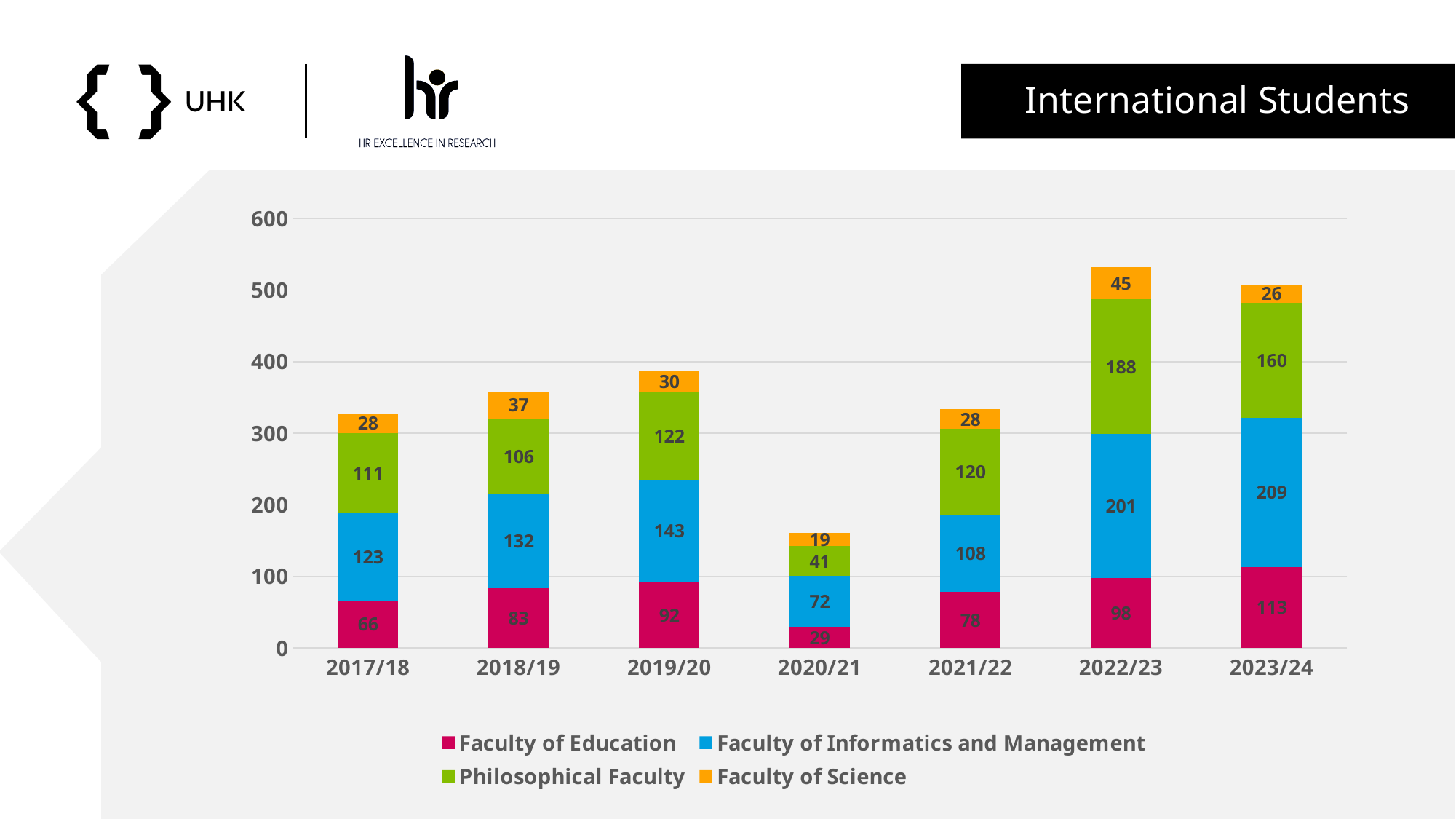
What is the total of the stacked bar for 2022/23? 532 In which academic year is the Faculty of Informatics and Management value the lowest? 2020/21 What kind of chart is shown on the slide? Stacked bar chart What is the total of the stacked bar for 2020/21? 161 What is the value for the Faculty of Informatics and Management in 2022/23? 201 What is the value for the Faculty of Science in 2020/21? 19 What is the value for the Philosophical Faculty in 2019/20? 122 In which academic year is the Faculty of Education value the highest? 2023/24 What is the difference between the Philosophical Faculty values in 2022/23 and 2023/24? 28 How many series does the legend list? 4 Which is larger: the Faculty of Science value in 2018/19 or in 2019/20? 2018/19 How many academic years are shown on the x axis? 7